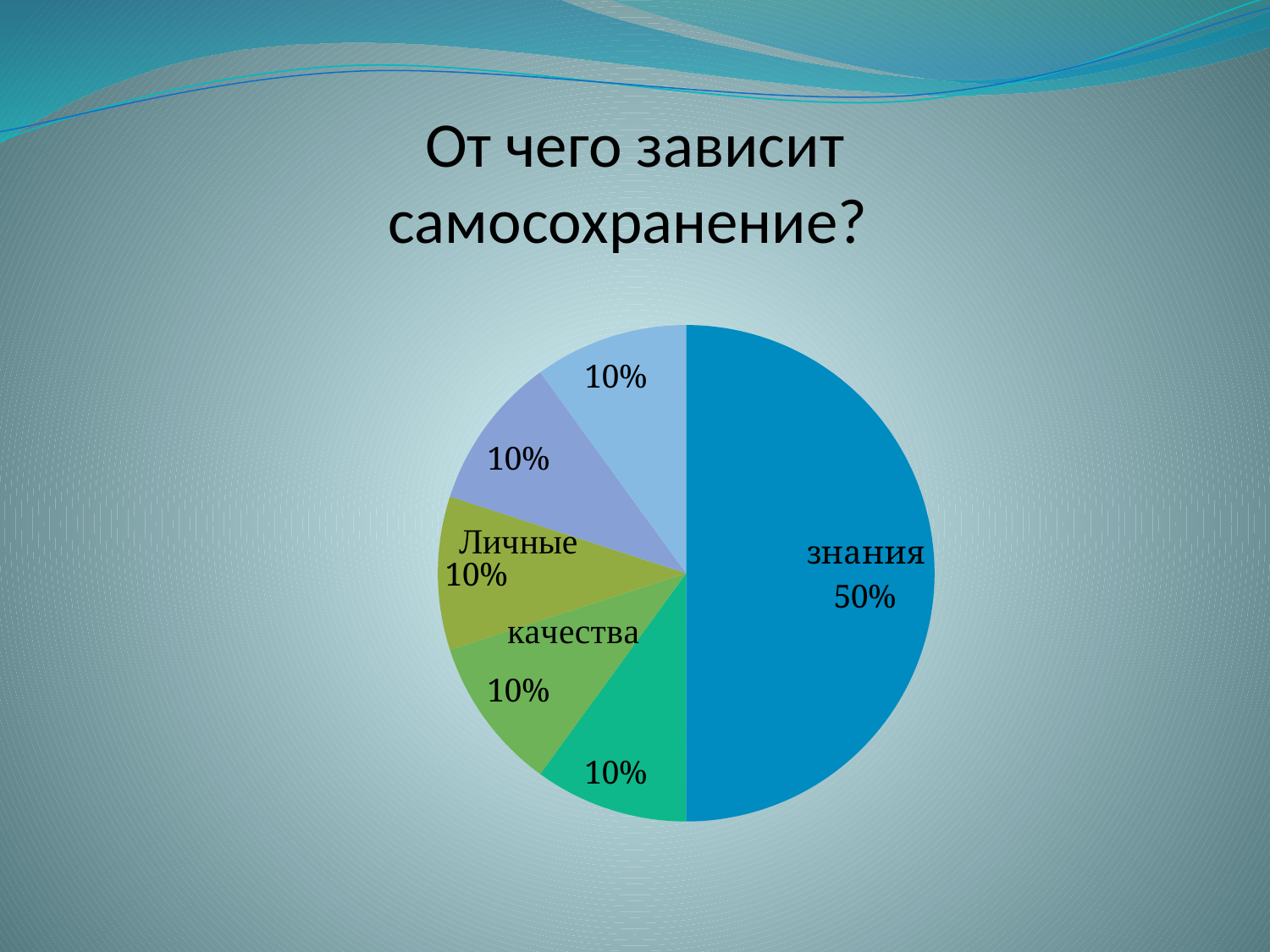
What is the title of the chart on the slide? От чего зависит самосохранение? What is the combined share of all the slices labelled 10%? 50% What value is shown for the 'знания' slice? 50% Which is larger, the 'знания' slice or the 'Личные качества' slice? знания Which slice of the pie chart is the largest? знания What is the difference between the 'знания' slice and the 'Личные качества' slice? 40% How many slices of the pie chart are labelled 10%? 5 Is the share of the 'знания' slice greater or less than 40%? greater What kind of chart is shown on the slide? pie chart How many slices does the pie chart have? 6 What share of the pie does the 'знания' slice take? 50% What value is shown for the slice labelled 'Личные качества'? 10%